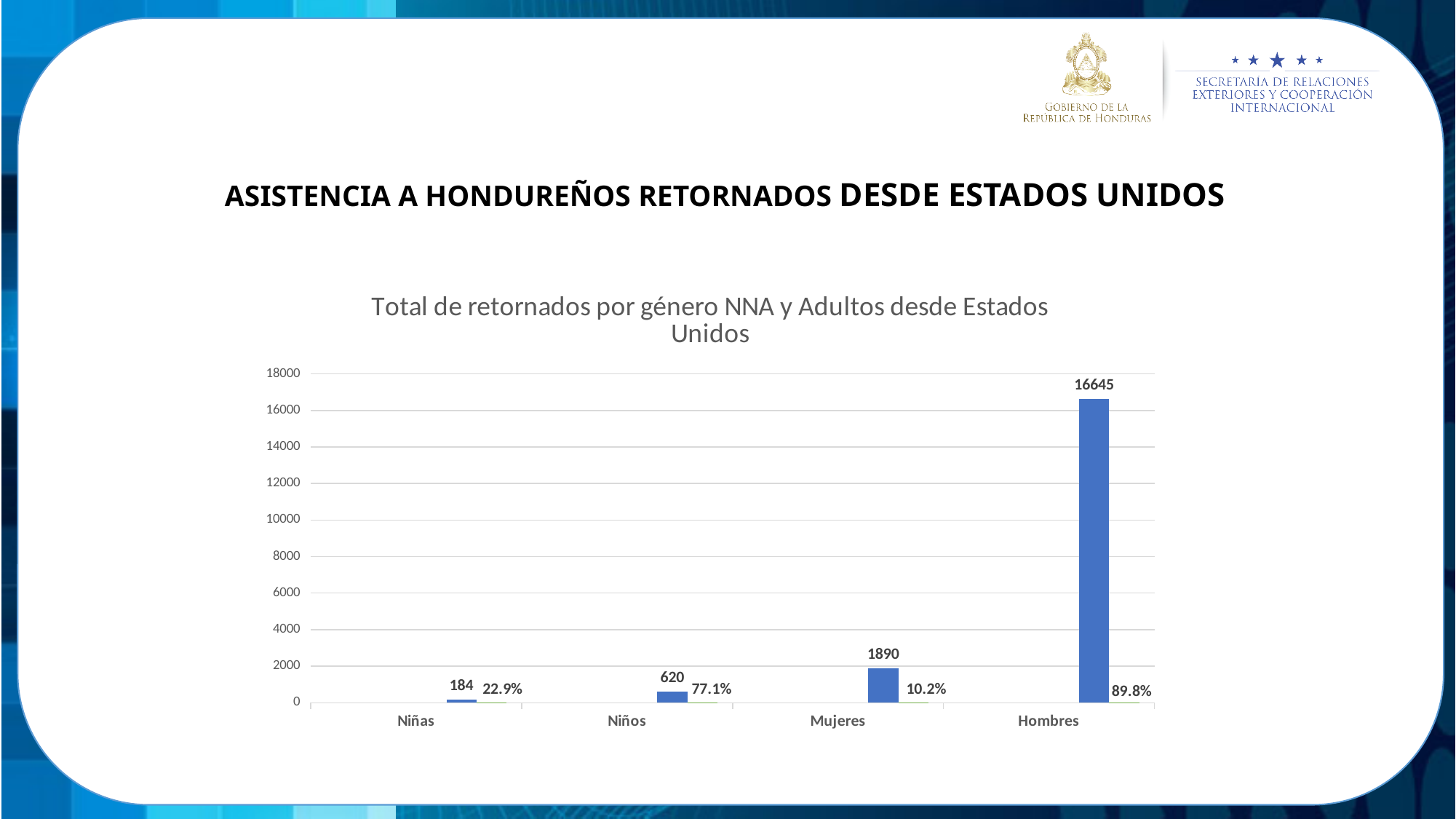
What is the value for Niños? 620 Which category has the highest value? Hombres What is the difference between the values for Hombres and Mujeres? 14755 What is the value for Hombres? 16645 How many categories are shown on the x axis? 4 What type of chart is shown? Bar chart What is the value for Mujeres? 1890 What is the value for Niñas? 184 What percentage is shown next to the Niños bar? 77.1% Which category has the lowest value? Niñas What percentage is shown next to the Hombres bar? 89.8% Which is larger, the value for Niños or the value for Mujeres? Mujeres